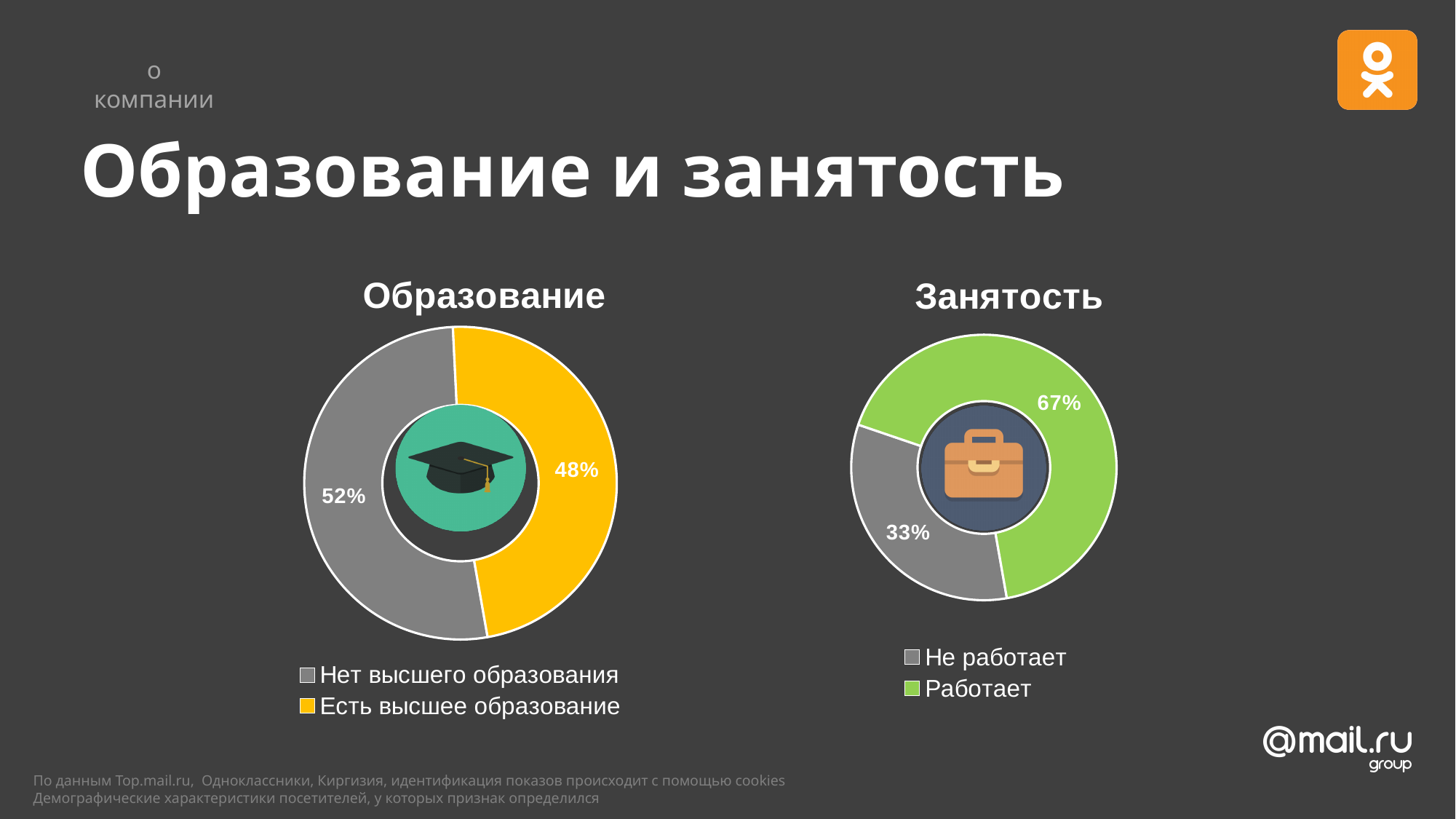
What type of chart is the "Занятость" chart? Pie chart (doughnut) In the "Образование" chart, which category has the smallest slice? Есть высшее образование In the "Образование" chart, what share is labelled for "Есть высшее образование"? 48% In the "Занятость" chart, which is larger: "Не работает" or "Работает"? Работает In the "Занятость" chart, what share is labelled for "Не работает"? 33% In the "Занятость" chart, what is the difference in percentage points between "Работает" and "Не работает"? 34 In the "Образование" chart, what share is labelled for "Нет высшего образования"? 52% In the "Занятость" chart, what share is labelled for "Работает"? 67% How many slices does the "Образование" chart have? 2 In the "Занятость" chart, what colour is the "Работает" slice? Green In the "Занятость" chart, which category has the largest slice? Работает In the "Образование" chart, what is the difference in percentage points between "Нет высшего образования" and "Есть высшее образование"? 4